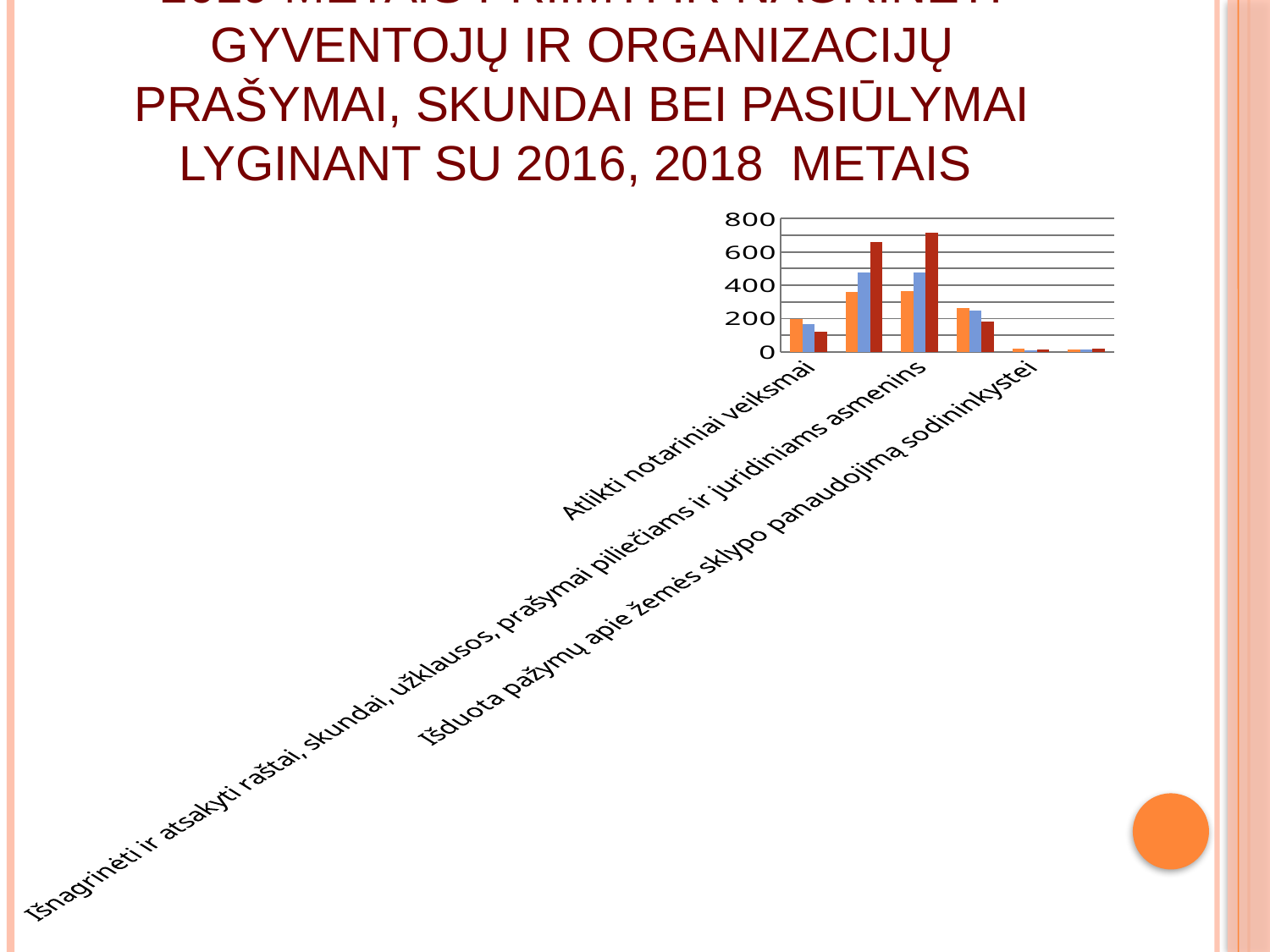
Are the bars for "Išduota pažymų apie žemės sklypo panaudojimą sodininkystei" greater or less than 200? less Is the value of the orange bar for "Atlikti notariniai veiksmai" greater or less than 400? less How many bars are plotted for each category on the chart? 3 Is the value of the dark red bar for "Išnagrinėti ir atsakyti raštai, skundai, užklausos, prašymai piliečiams ir juridiniams asmenins" greater or less than 600? greater For "Išnagrinėti ir atsakyti raštai, skundai, užklausos, prašymai piliečiams ir juridiniams asmenins", which bar is taller: the orange bar or the dark red bar? the dark red bar What kind of chart is shown on the slide? bar chart What is the highest value shown on the chart's vertical axis? 800 What is the interval between tick marks on the chart's vertical axis? 200 For "Atlikti notariniai veiksmai", which bar is taller: the orange bar or the dark red bar? the orange bar Which labelled category has the lowest bars on the chart? Išduota pažymų apie žemės sklypo panaudojimą sodininkystei Which labelled category has the tallest bar on the chart? Išnagrinėti ir atsakyti raštai, skundai, užklausos, prašymai piliečiams ir juridiniams asmenins